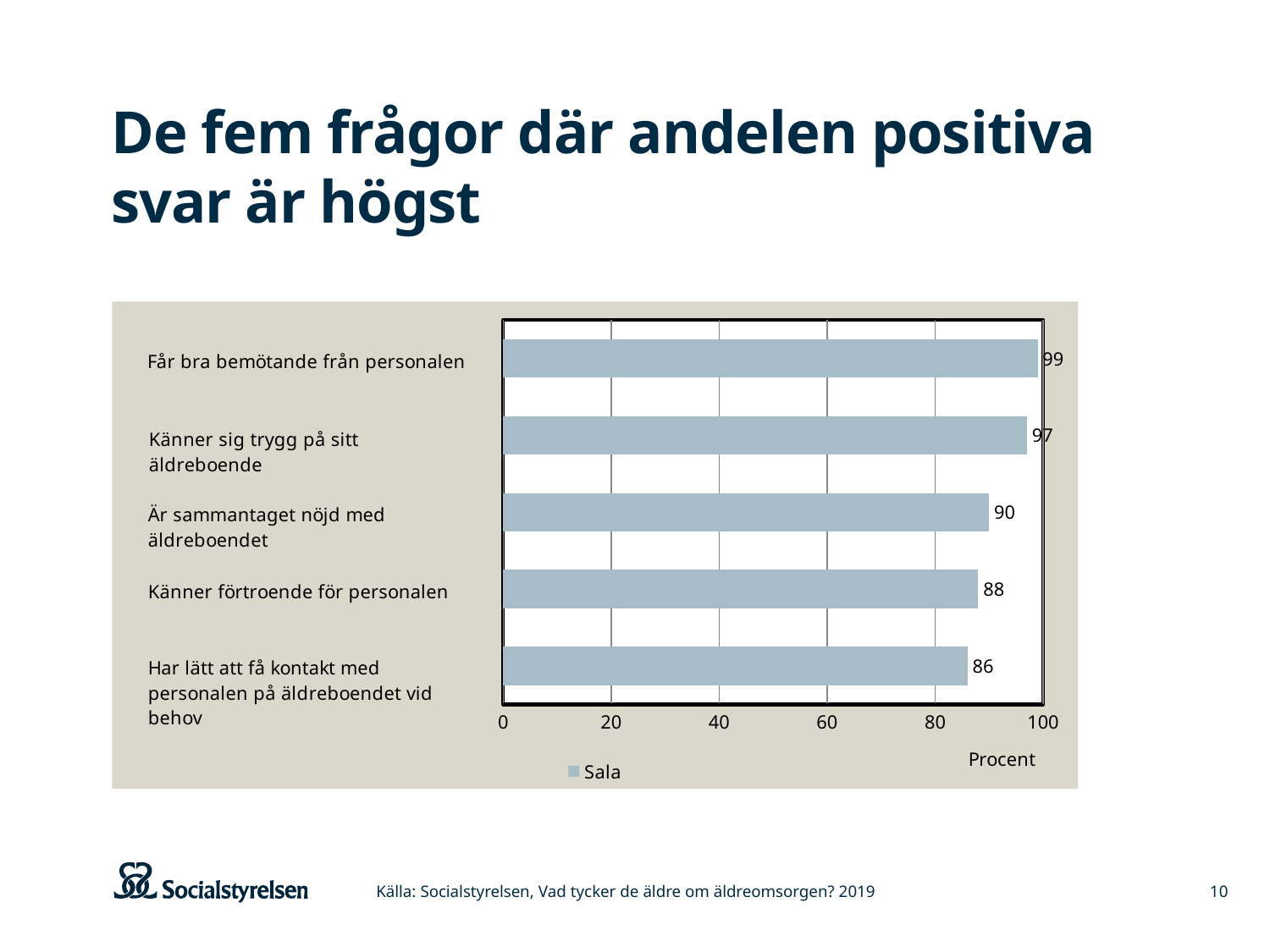
What kind of chart is shown on the slide? Bar chart What is the value for "Känner sig trygg på sitt äldreboende"? 97 What is the difference between the values for "Får bra bemötande från personalen" and "Har lätt att få kontakt med personalen på äldreboendet vid behov"? 13 What series does the legend list? Sala What is the value for "Får bra bemötande från personalen"? 99 Which category has the highest value? Får bra bemötande från personalen What is the value for "Känner förtroende för personalen"? 88 Which is larger: the value for "Är sammantaget nöjd med äldreboendet" or the value for "Känner förtroende för personalen"? Är sammantaget nöjd med äldreboendet What is the value for "Är sammantaget nöjd med äldreboendet"? 90 What is the value for "Har lätt att få kontakt med personalen på äldreboendet vid behov"? 86 How many categories are shown in the chart? 5 Which category has the lowest value? Har lätt att få kontakt med personalen på äldreboendet vid behov